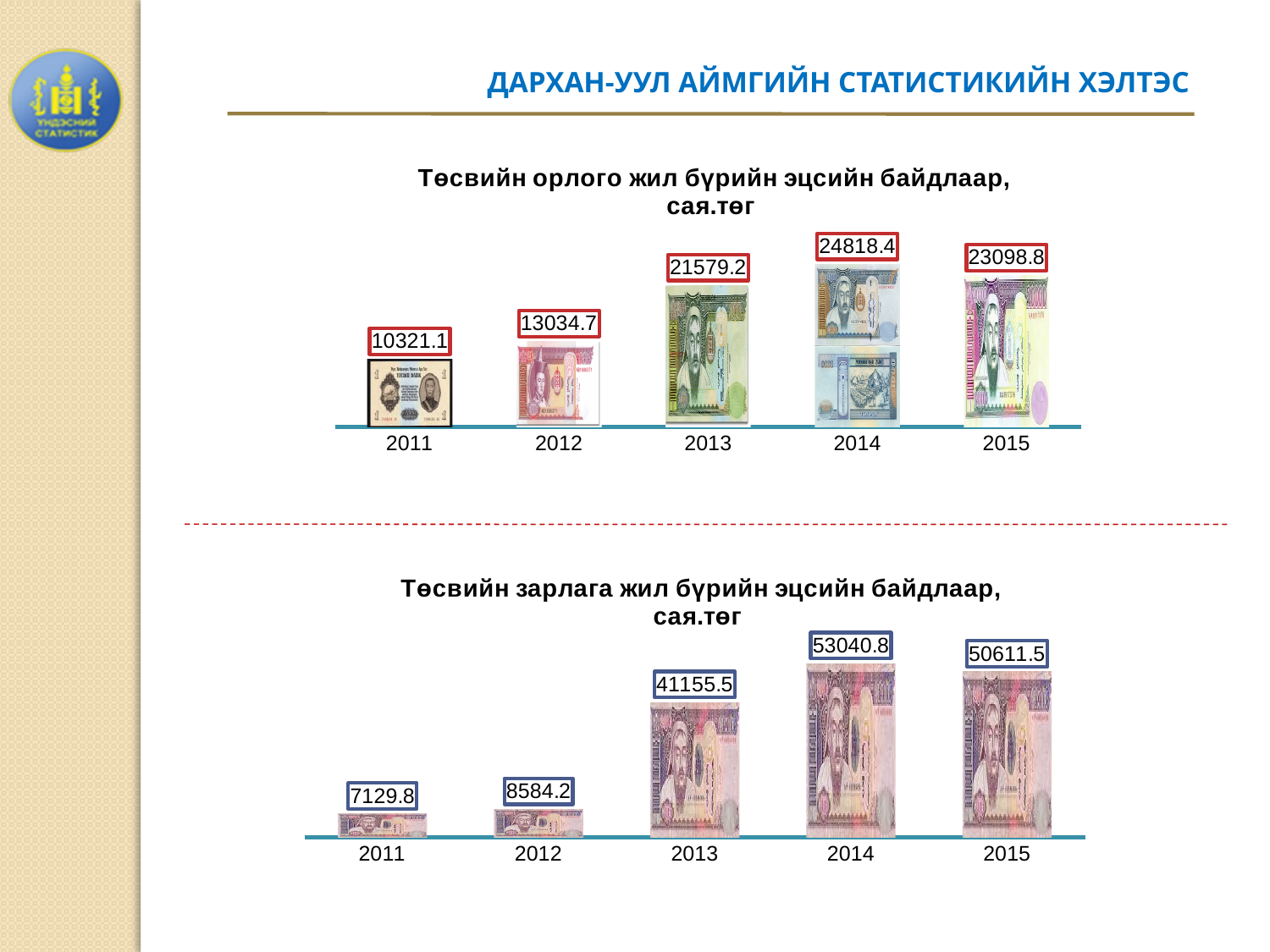
What kind of chart is the top chart (Төсвийн орлого)? bar chart In the bottom chart (Төсвийн зарлага), which is larger, the value for 2013 or the value for 2015? 2015 In the bottom chart (Төсвийн зарлага), which year has the highest value? 2014 In the bottom chart (Төсвийн зарлага), what is the value for 2015? 50611.5 In the top chart (Төсвийн орлого), which year has the lowest value? 2011 In the top chart (Төсвийн орлого), which year has the highest value? 2014 In the top chart (Төсвийн орлого), what is the value for 2011? 10321.1 In the bottom chart (Төсвийн зарлага), what is the difference between the 2014 and 2015 values? 2429.3 In the top chart (Төсвийн орлого), what is the value for 2013? 21579.2 In the top chart (Төсвийн орлого), what is the difference between the 2014 and 2013 values? 3239.2 In the bottom chart (Төсвийн зарлага), what is the value for 2012? 8584.2 How many years are shown on the x axis of the bottom chart (Төсвийн зарлага)? 5